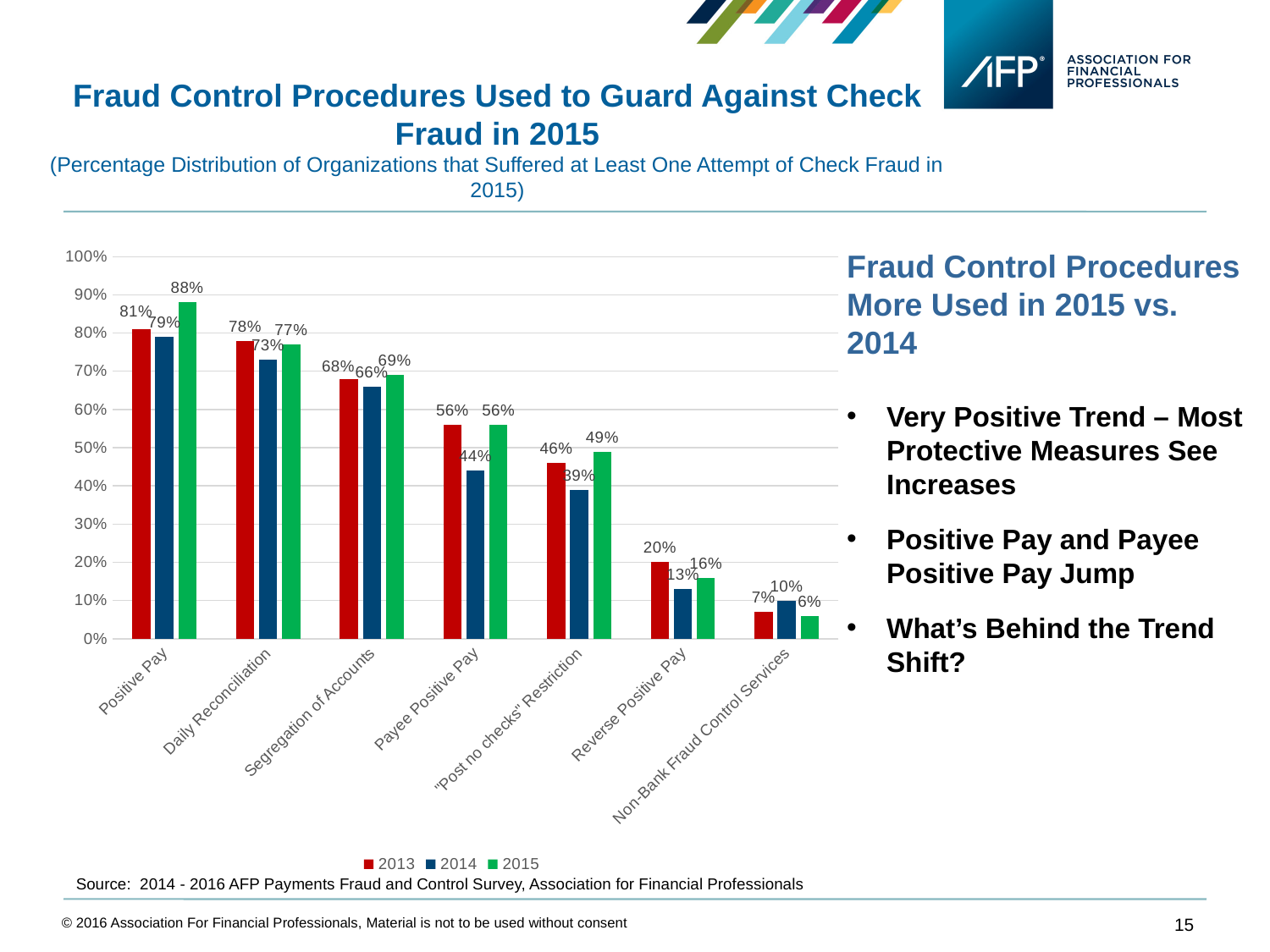
What is the 2014 value for Non-Bank Fraud Control Services? 10% How many categories are shown on the x axis? 7 What is the 2014 value for Payee Positive Pay? 44% Do the 2015 values rise or fall moving from Positive Pay to Non-Bank Fraud Control Services along the x axis? Fall What kind of chart is shown on the slide? Bar chart Which category has the lowest 2013 value? Non-Bank Fraud Control Services How many series does the legend list? 3 Which category has the highest 2015 value? Positive Pay Which is larger for "Post no checks" Restriction: the 2013 value or the 2015 value? 2015 What is the difference between the 2015 and 2014 values for Positive Pay? 9% What is the 2013 value for Reverse Positive Pay? 20% What is the 2015 value for Positive Pay? 88%